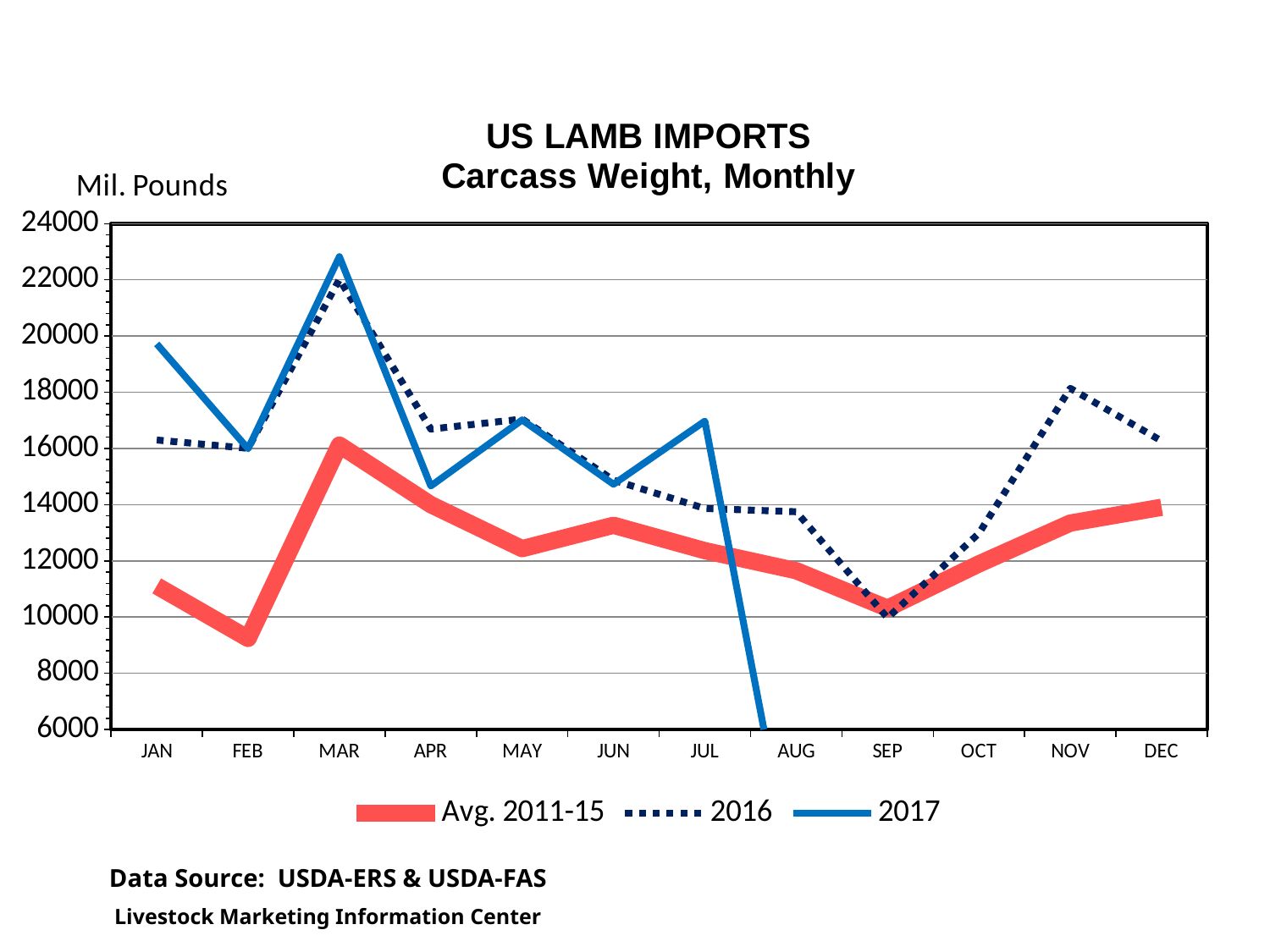
In which month does the 2017 series reach its highest value? MAR How many series does the legend list? 3 Is the Avg. 2011-15 value for FEB greater or less than 10000? less In which month does the 2016 series reach its lowest value? SEP Is the 2016 value for NOV greater or less than 16000? greater Is the 2017 value for JAN greater or less than 18000? greater How many months are shown along the x axis? 12 In which month is the Avg. 2011-15 series at its lowest? FEB What kind of chart is shown on the slide? Line chart What unit is given for the y axis? Mil. Pounds In APR, which series has the larger value, 2016 or 2017? 2016 Does the Avg. 2011-15 series rise or fall from SEP to DEC? Rise